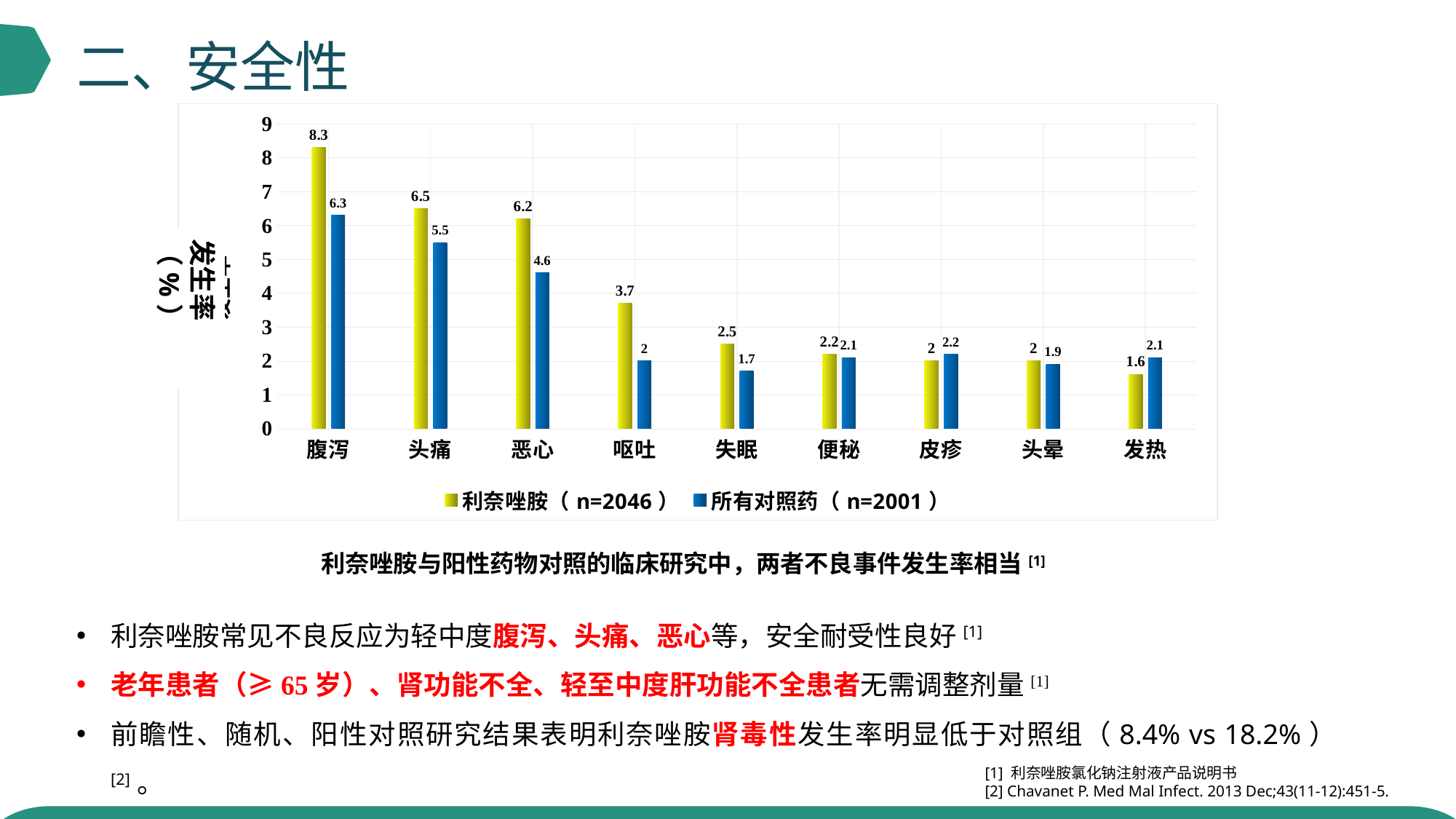
What colour are the bars for the 所有对照药（n=2001） series? blue What is the difference between the 利奈唑胺（n=2046） and 所有对照药（n=2001） values for 头痛? 1 How many series does the legend list? 2 Which category has the lowest value in the 利奈唑胺（n=2046） series? 发热 Do the 利奈唑胺（n=2046） values generally rise or fall from 腹泻 to 发热 along the x axis? fall What kind of chart is shown on the slide? bar chart For 发热, which series has the larger value, 利奈唑胺（n=2046） or 所有对照药（n=2001）? 所有对照药（n=2001） What is the value for 呕吐 in the 所有对照药（n=2001） series? 2 What is the value for 腹泻 in the 利奈唑胺（n=2046） series? 8.3 Which category has the highest value in the 利奈唑胺（n=2046） series? 腹泻 What is the value for 恶心 in the 所有对照药（n=2001） series? 4.6 How many categories are shown on the x axis? 9